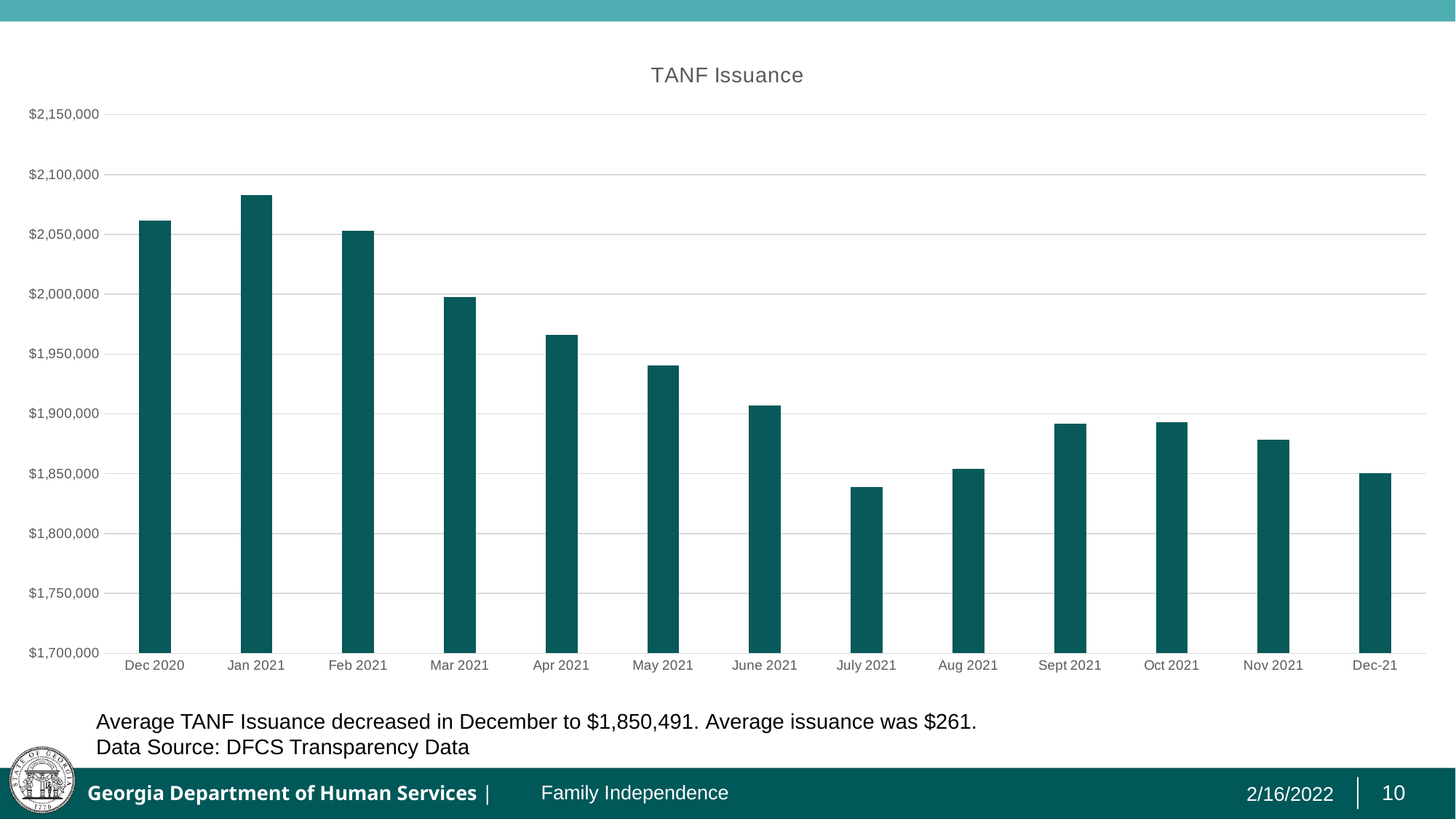
What was the TANF issuance in Dec-21, according to the text on the slide? $1,850,491 Is the value for Nov 2021 greater or less than $1,900,000? less Overall, do the values rise or fall from Dec 2020 to Dec-21? fall Is the value for July 2021 greater or less than $1,850,000? less Is the value for Feb 2021 greater or less than $2,000,000? greater How many months are plotted on the chart? 13 What is the title of the chart? TANF Issuance Which is larger, the value for Jan 2021 or Feb 2021? Jan 2021 What kind of chart is shown on the slide? Bar chart Which month has the lowest TANF issuance? July 2021 Which month has the highest TANF issuance? Jan 2021